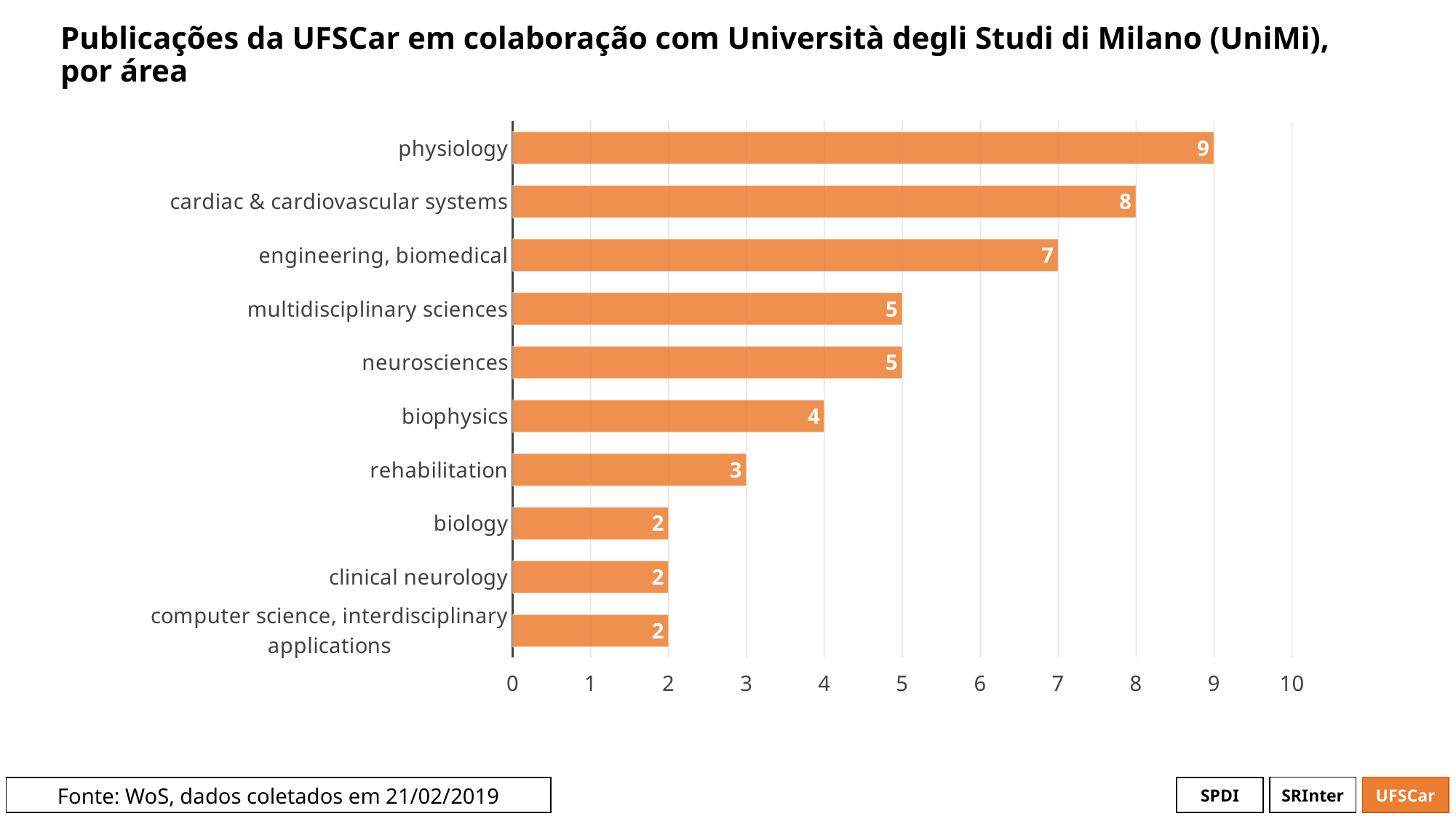
What is the source of the data cited on the slide? WoS, dados coletados em 21/02/2019 What is the difference between the values for engineering, biomedical and biophysics? 3 Which is larger, the value for neurosciences or the value for rehabilitation? neurosciences Which area has the highest number of publications? physiology How many areas have a value of 2? 3 What is the difference between the values for physiology and cardiac & cardiovascular systems? 1 How many publications are shown for physiology? 9 How many areas are shown in the chart? 10 Is the value for cardiac & cardiovascular systems greater or less than 5? greater What kind of chart is shown on the slide? bar chart What is the value for engineering, biomedical? 7 What is the value for rehabilitation? 3